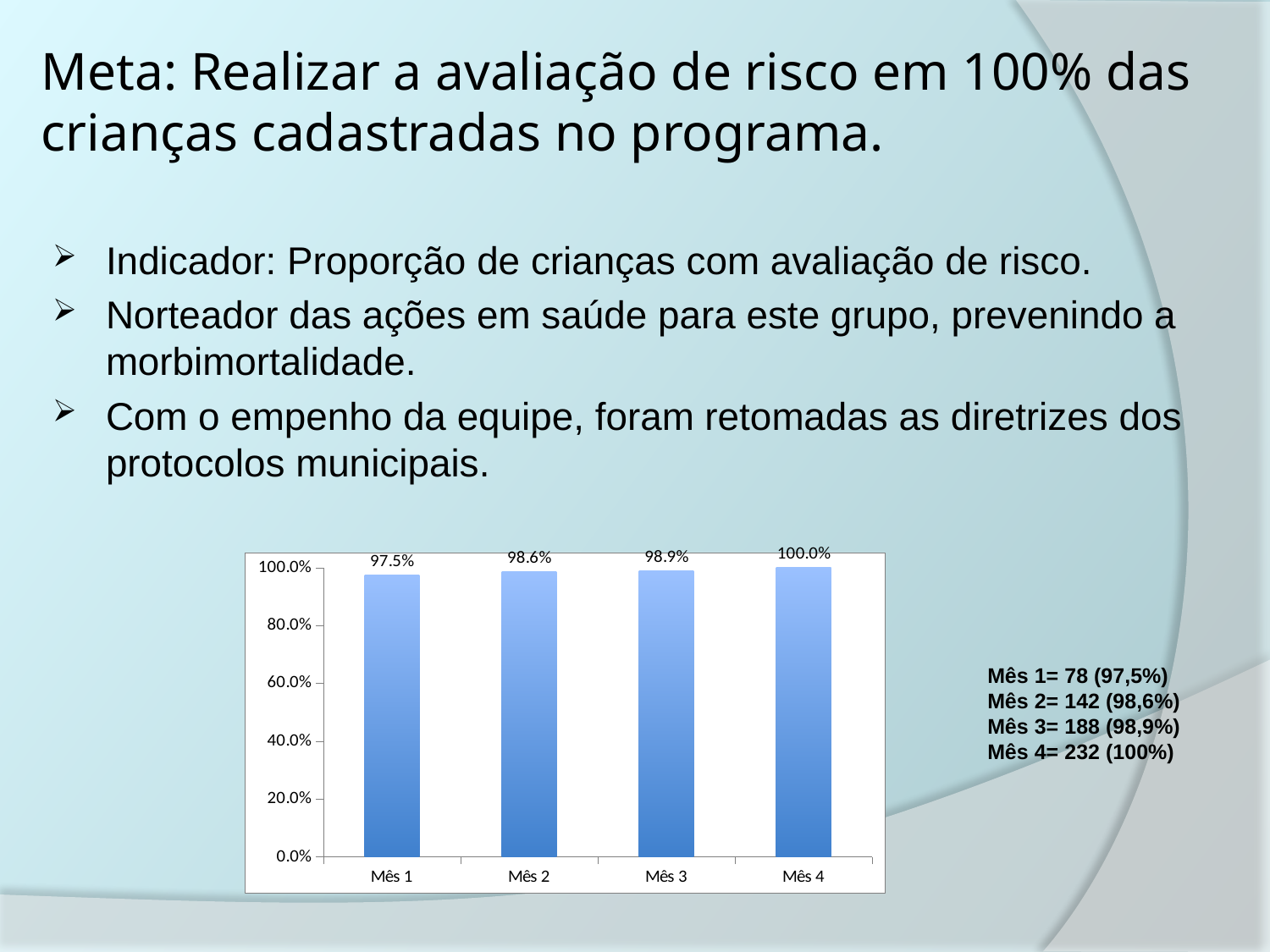
What is the value shown for Mês 2? 98.6% What kind of chart is shown on the slide? bar chart What is the difference between the values for Mês 4 and Mês 1? 2.5% Which month has the lowest value in the chart? Mês 1 What is the value shown for Mês 3? 98.9% What is the value shown for Mês 1? 97.5% How many months (categories) are shown on the x axis of the chart? 4 Do the values rise or fall from Mês 1 to Mês 4? rise Which month has the highest value in the chart? Mês 4 Is the value for Mês 1 greater or less than 80.0%? greater Which is larger, the value for Mês 2 or the value for Mês 3? Mês 3 What is the value shown for Mês 4? 100.0%